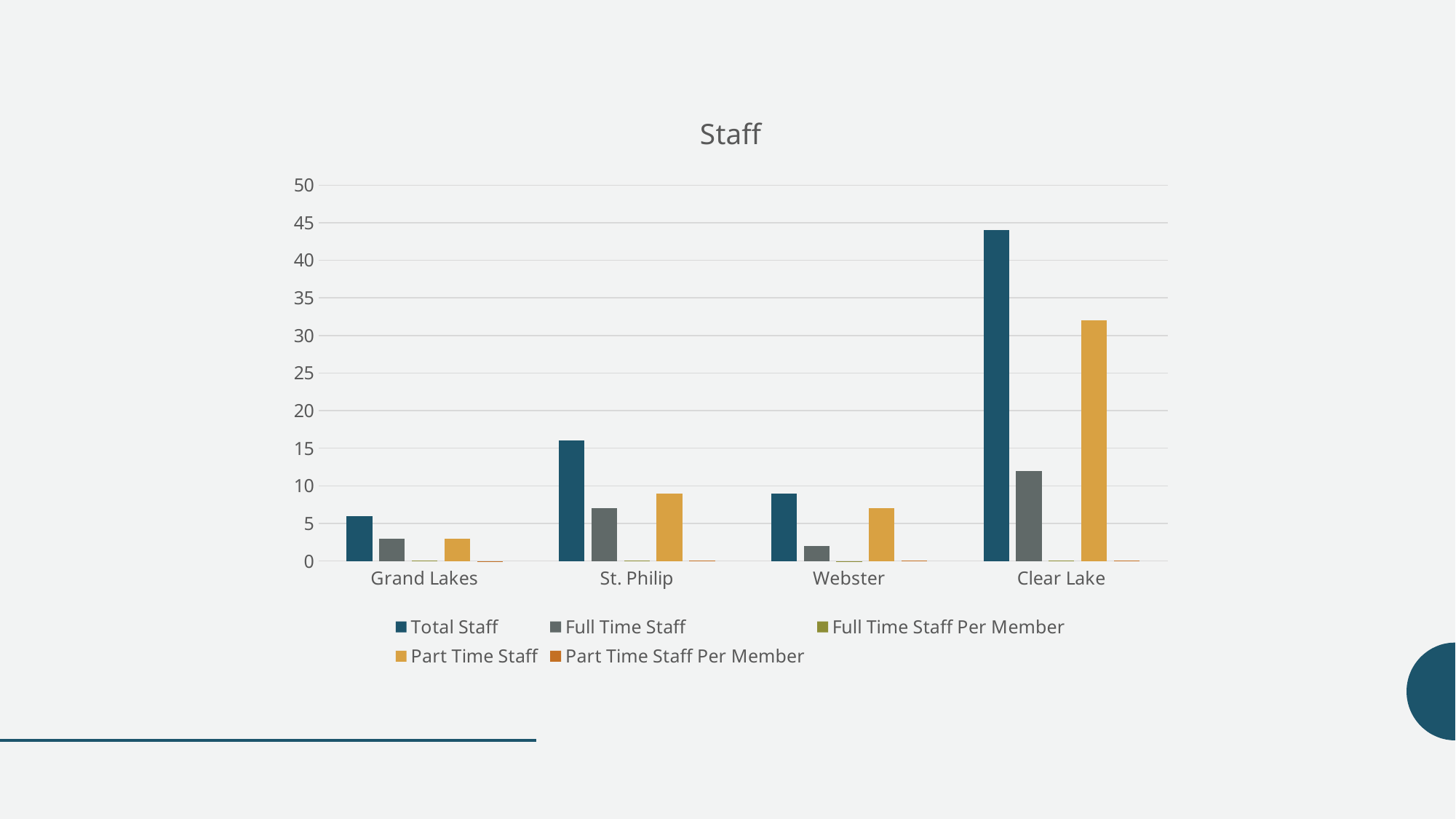
Is the Total Staff value for Clear Lake greater or less than 40? greater Which category has the highest Part Time Staff? Clear Lake Which category has the highest Total Staff? Clear Lake What kind of chart is shown on the slide? bar chart How many categories are shown on the x axis? 4 Is the Total Staff value for St. Philip greater or less than 10? greater What is the title of the chart? Staff Is the Total Staff value for Grand Lakes greater or less than 10? less How many series does the legend list? 5 Which is larger, the Total Staff for St. Philip or the Total Staff for Webster? St. Philip Which category has the lowest Total Staff? Grand Lakes